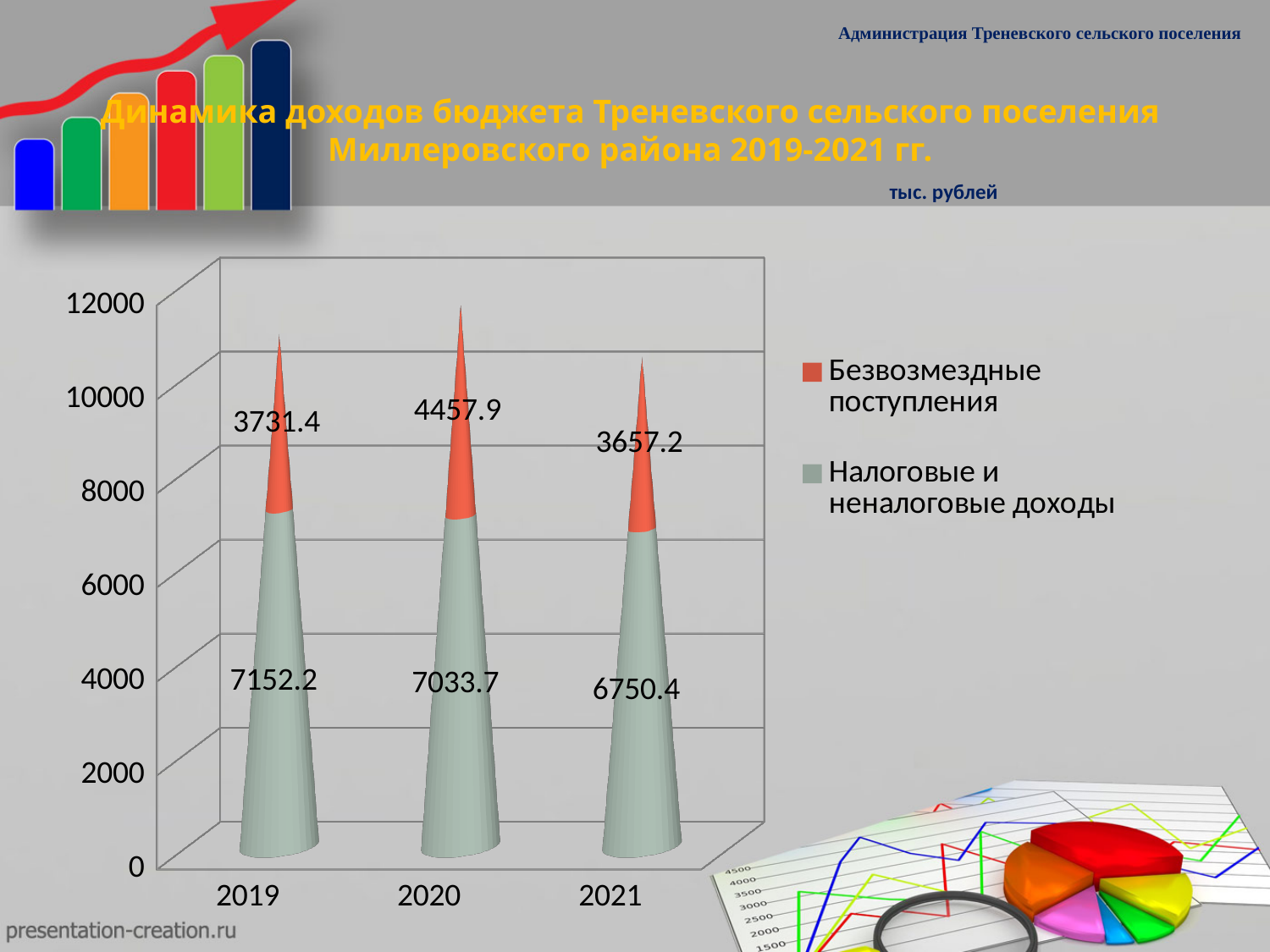
How many series does the legend list? 2 In which year is Налоговые и неналоговые доходы lowest? 2021 What is the total of the stacked bar for 2020? 11491.6 What is the difference between Налоговые и неналоговые доходы in 2019 and 2020? 118.5 What is the value of Налоговые и неналоговые доходы for 2019? 7152.2 What is the difference between Безвозмездные поступления in 2020 and 2021? 800.7 How many years are shown on the x axis? 3 What is the value of Налоговые и неналоговые доходы for 2021? 6750.4 Which is larger: Безвозмездные поступления in 2019 or in 2021? 2019 What kind of chart is shown on the slide? Stacked bar chart What is the value of Безвозмездные поступления for 2020? 4457.9 In which year is Безвозмездные поступления highest? 2020